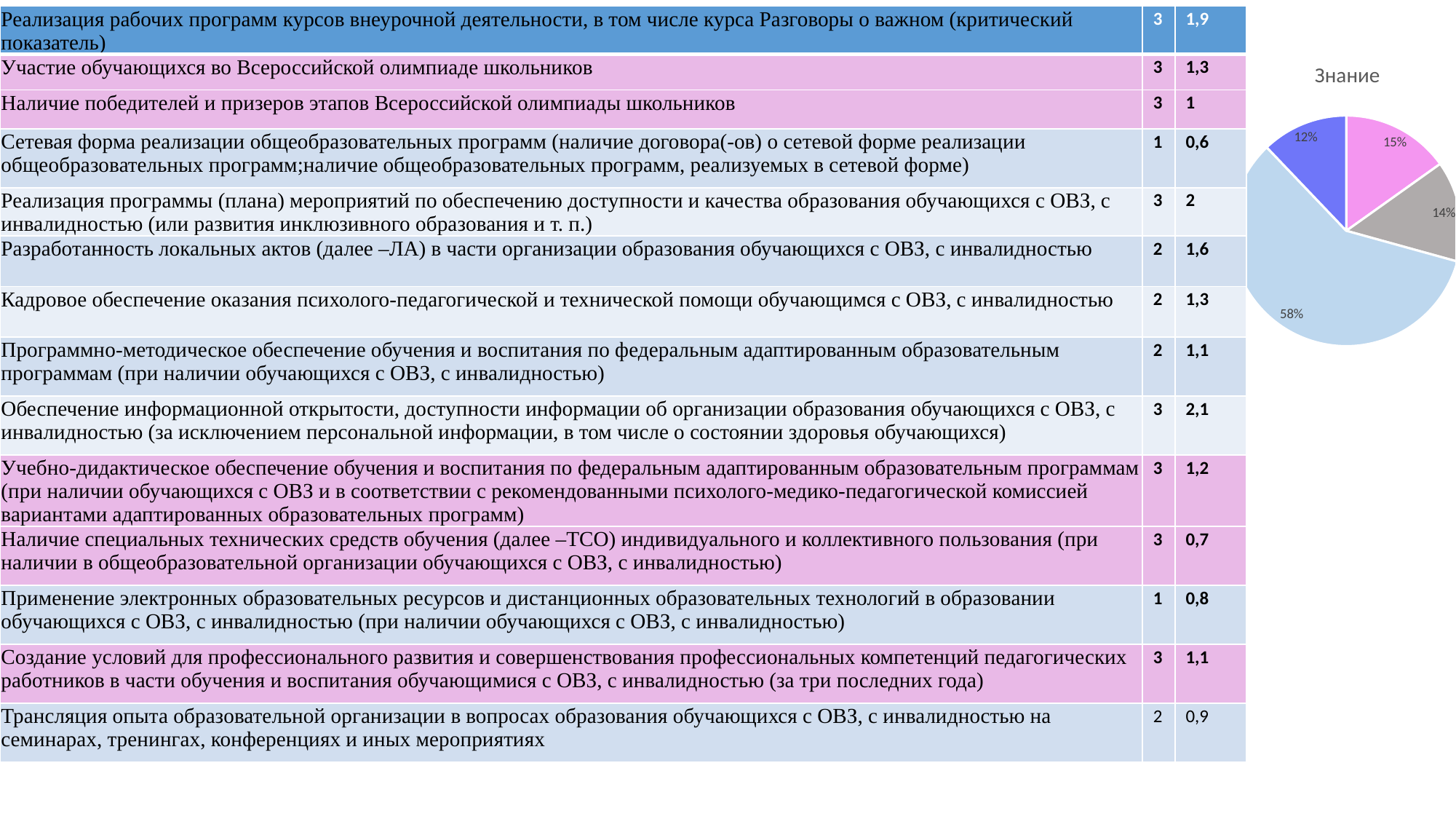
What is the title of the pie chart? Знание What share is shown for the pink slice of the pie chart? 15% What share is shown for the dark blue slice of the pie chart? 12% What is the largest share shown in the pie chart? 58% Does the pie chart have a legend? No What share is shown for the grey slice of the pie chart? 14% What is the difference in percentage points between the largest and smallest slices of the pie chart? 46 In the pie chart, which is larger: the pink slice or the grey slice? pink slice What is the smallest share shown in the pie chart? 12% What share is shown for the light blue slice of the pie chart? 58% How many slices does the pie chart have? 4 What kind of chart is shown on the right side of the slide? pie chart